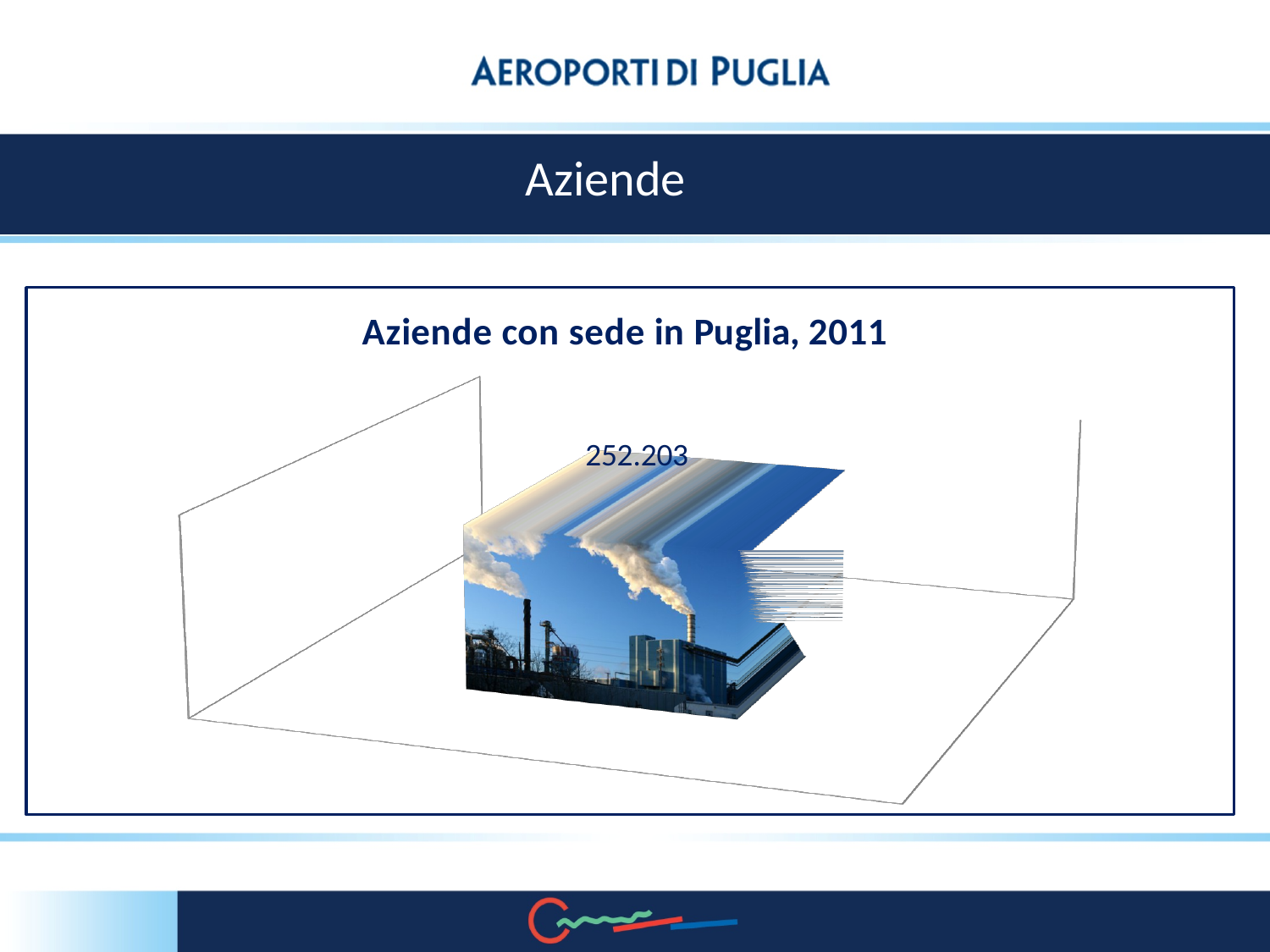
What kind of chart is "Aziende con sede in Puglia, 2011"? bar chart How many bars are plotted in the chart "Aziende con sede in Puglia, 2011"? 1 What year does the chart title "Aziende con sede in Puglia" refer to? 2011 What is the title of the chart on the slide? Aziende con sede in Puglia, 2011 What value is shown by the data label on the bar in the chart "Aziende con sede in Puglia, 2011"? 252.203